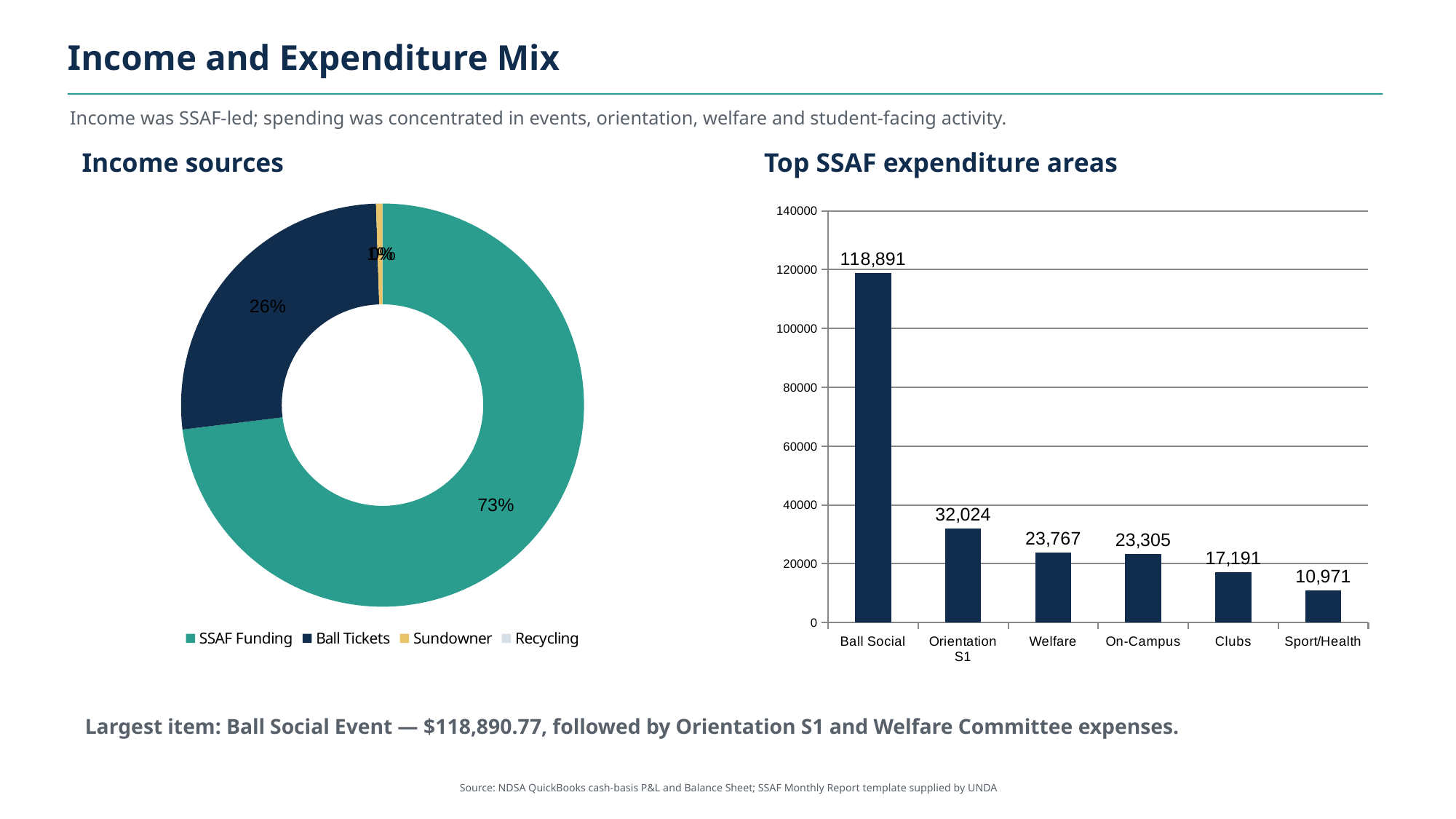
In the 'Top SSAF expenditure areas' chart, how many categories are shown? 6 In the 'Income sources' chart, what share does Ball Tickets have? 26% What kind of chart is 'Top SSAF expenditure areas'? Bar chart In the 'Top SSAF expenditure areas' chart, what is the value for Clubs? 17,191 In the 'Top SSAF expenditure areas' chart, what is the value for Ball Social? 118,891 In the 'Top SSAF expenditure areas' chart, which category has the highest value? Ball Social In the 'Top SSAF expenditure areas' chart, what is the difference between Welfare and On-Campus? 462 In the 'Income sources' chart, what share does SSAF Funding have? 73% In the 'Top SSAF expenditure areas' chart, what is the value for Orientation S1? 32,024 In the 'Top SSAF expenditure areas' chart, which is larger, Orientation S1 or Welfare? Orientation S1 How many entries does the legend of the 'Income sources' chart list? 4 In the 'Top SSAF expenditure areas' chart, which category has the lowest value? Sport/Health